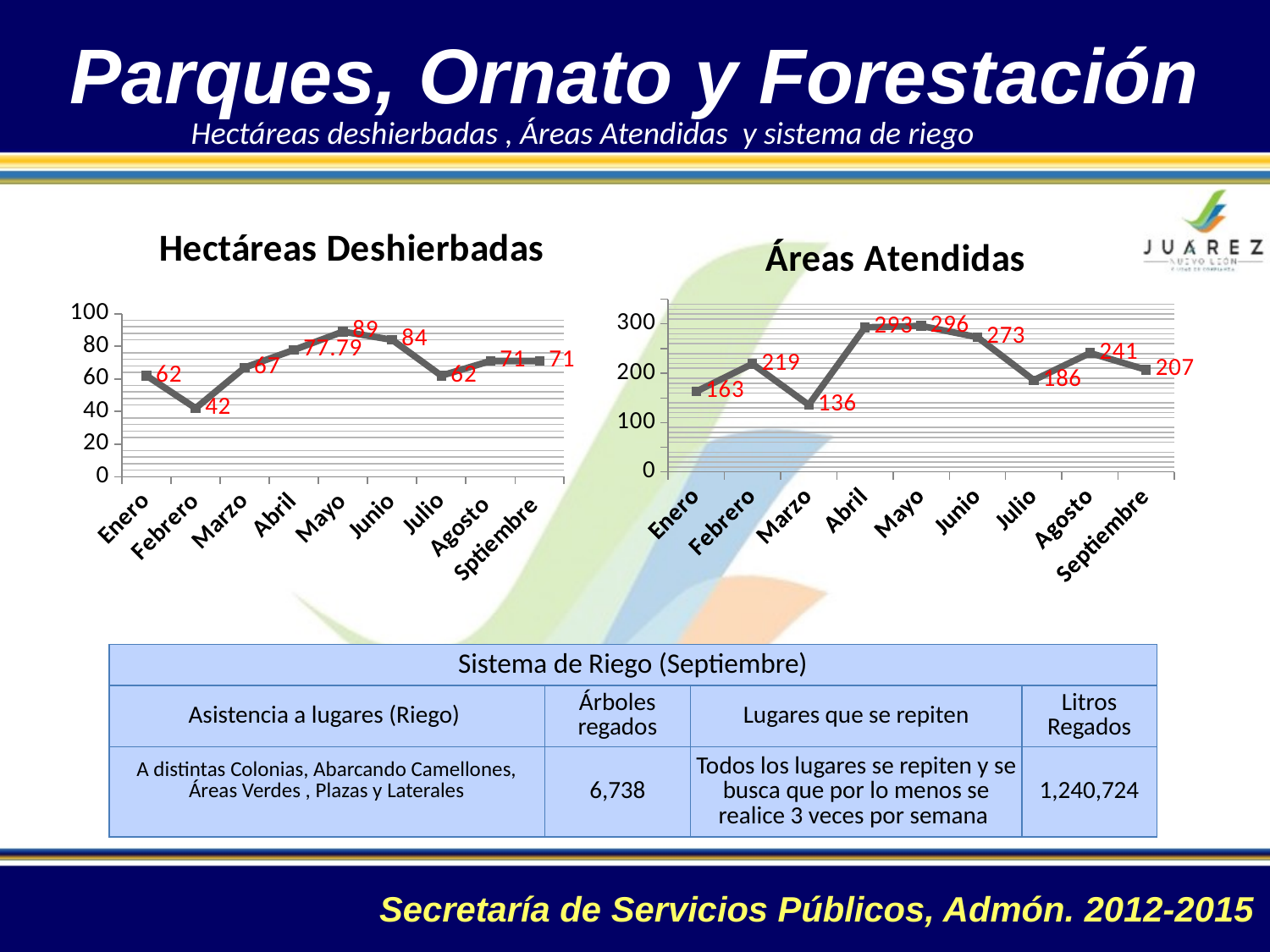
In the 'Hectáreas Deshierbadas' chart, which month has the lowest value? Febrero In the 'Áreas Atendidas' chart, what is the value for Marzo? 136 In the 'Hectáreas Deshierbadas' chart, what is the value for Abril? 77.79 In the 'Áreas Atendidas' chart, which is larger, the value for Febrero or the value for Julio? Febrero In the 'Áreas Atendidas' chart, what is the value for Agosto? 241 In the 'Hectáreas Deshierbadas' chart, what is the difference between the values for Mayo and Julio? 27 In the 'Hectáreas Deshierbadas' chart, what is the value for Febrero? 42 In the 'Hectáreas Deshierbadas' chart, how many months are plotted? 9 In the 'Hectáreas Deshierbadas' chart, which month has the highest value? Mayo In the 'Áreas Atendidas' chart, which month has the highest value? Mayo In the 'Áreas Atendidas' chart, what is the difference between the values for Abril and Enero? 130 What type of chart is the 'Áreas Atendidas' chart? Line chart